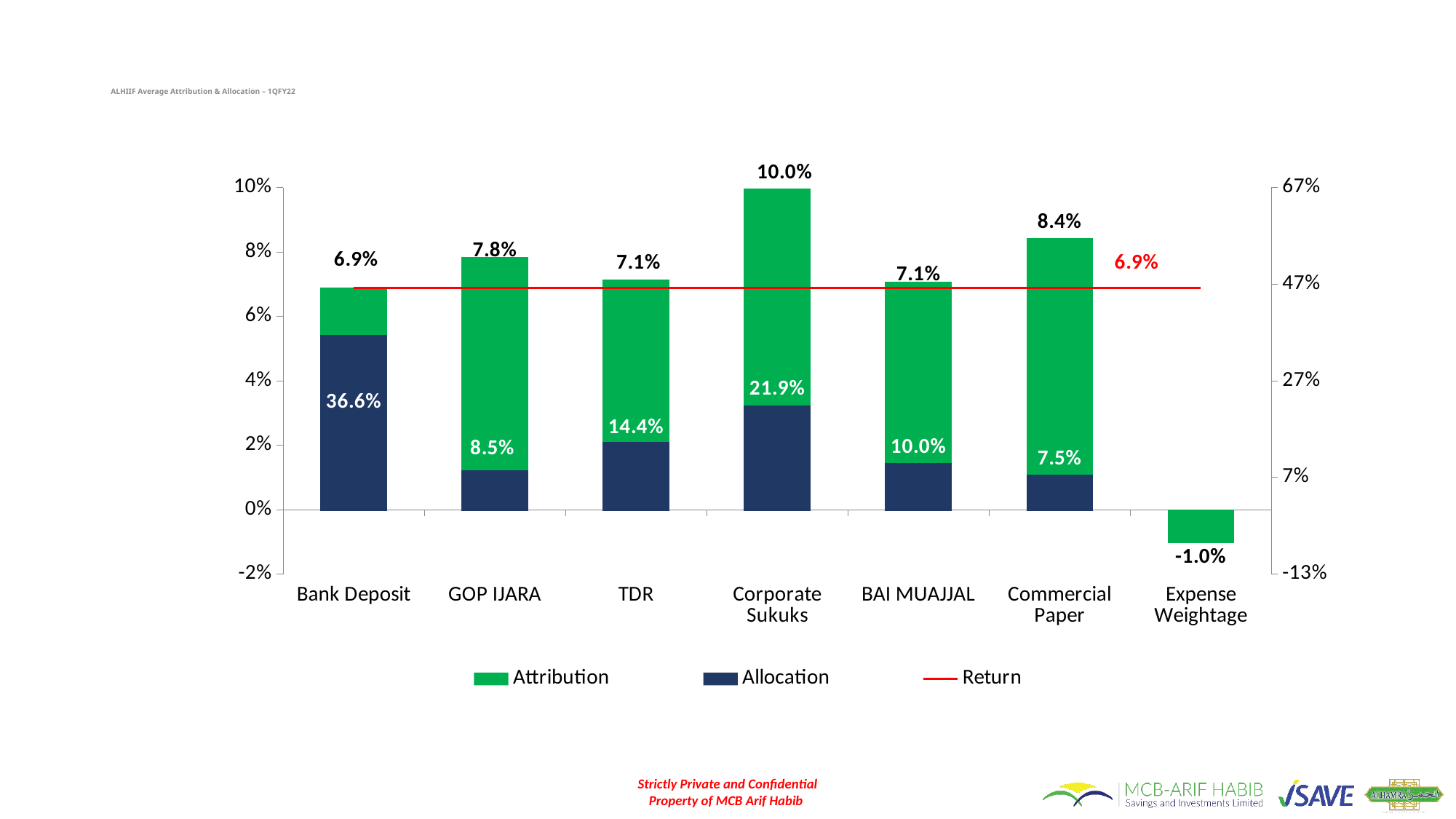
How many categories are shown on the x axis? 7 What value is labelled on the Return line? 6.9% What is the Attribution value for Expense Weightage? -1.0% Which has the larger Allocation value, TDR or BAI MUAJJAL? TDR Which category has the highest Attribution value? Corporate Sukuks What is the difference between the Attribution values for Corporate Sukuks and Commercial Paper? 1.6% How many series does the legend list? 3 What is the Attribution value for Corporate Sukuks? 10.0% What kind of chart is shown on the slide? Bar chart with a line Which category has the lowest Allocation value among those labelled? Commercial Paper What is the difference between the Allocation values for Bank Deposit and Corporate Sukuks? 14.7% What is the Allocation value for Bank Deposit? 36.6%